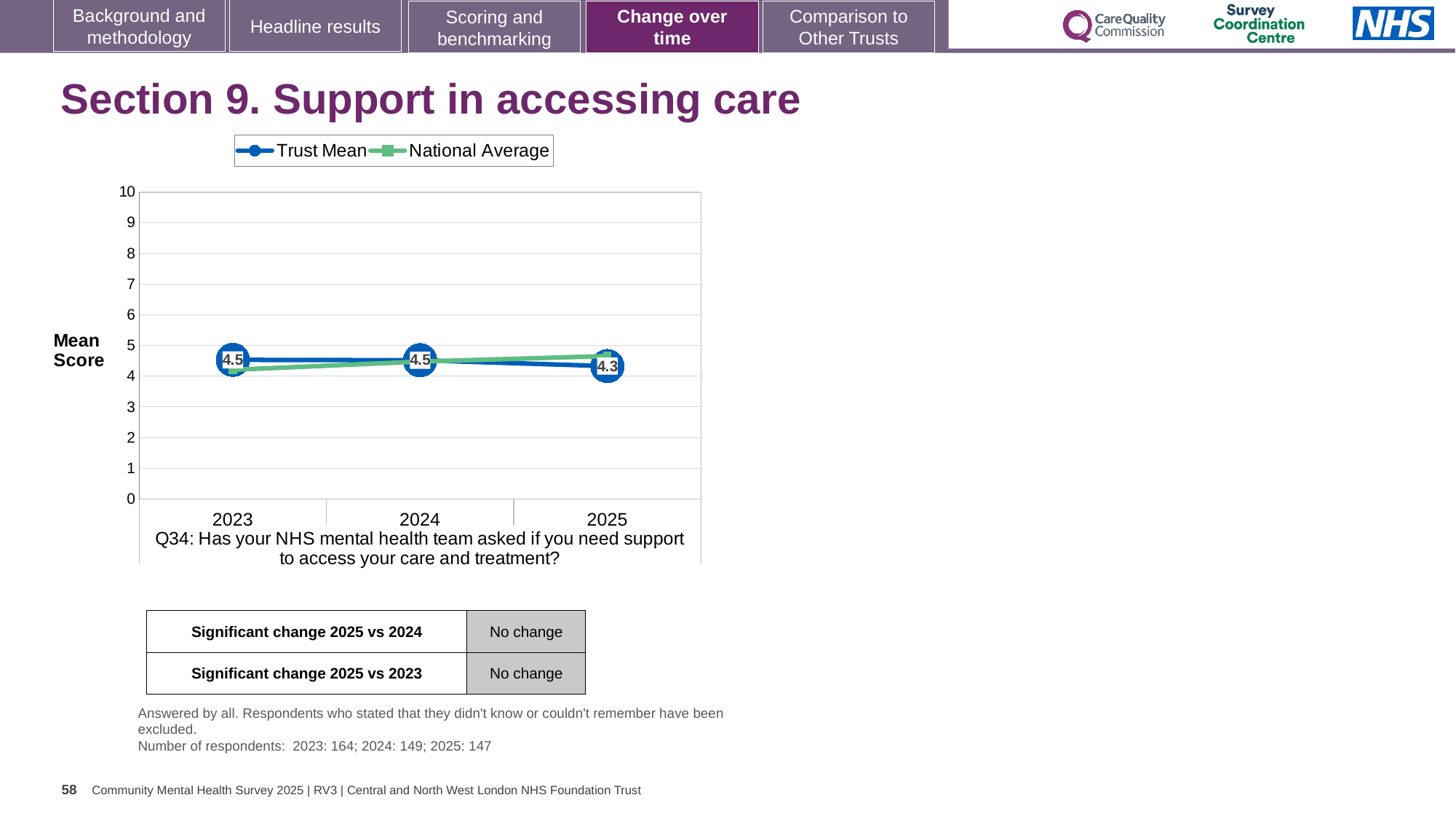
How many series does the legend list? 2 How many years are plotted on the x axis? 3 Is the National Average value for 2025 greater or less than 4? greater What is the difference between the Trust Mean in 2023 and in 2025? 0.2 What is the Trust Mean value for 2023? 4.5 What is the Trust Mean value for 2024? 4.5 What is the Trust Mean value for 2025? 4.3 What kind of chart is shown on the slide? Line chart Which is larger, the Trust Mean in 2024 or the Trust Mean in 2025? 2024 Is the National Average value for 2023 greater or less than 5? less In which year is the Trust Mean lowest? 2025 What is the label on the y axis of the chart? Mean Score